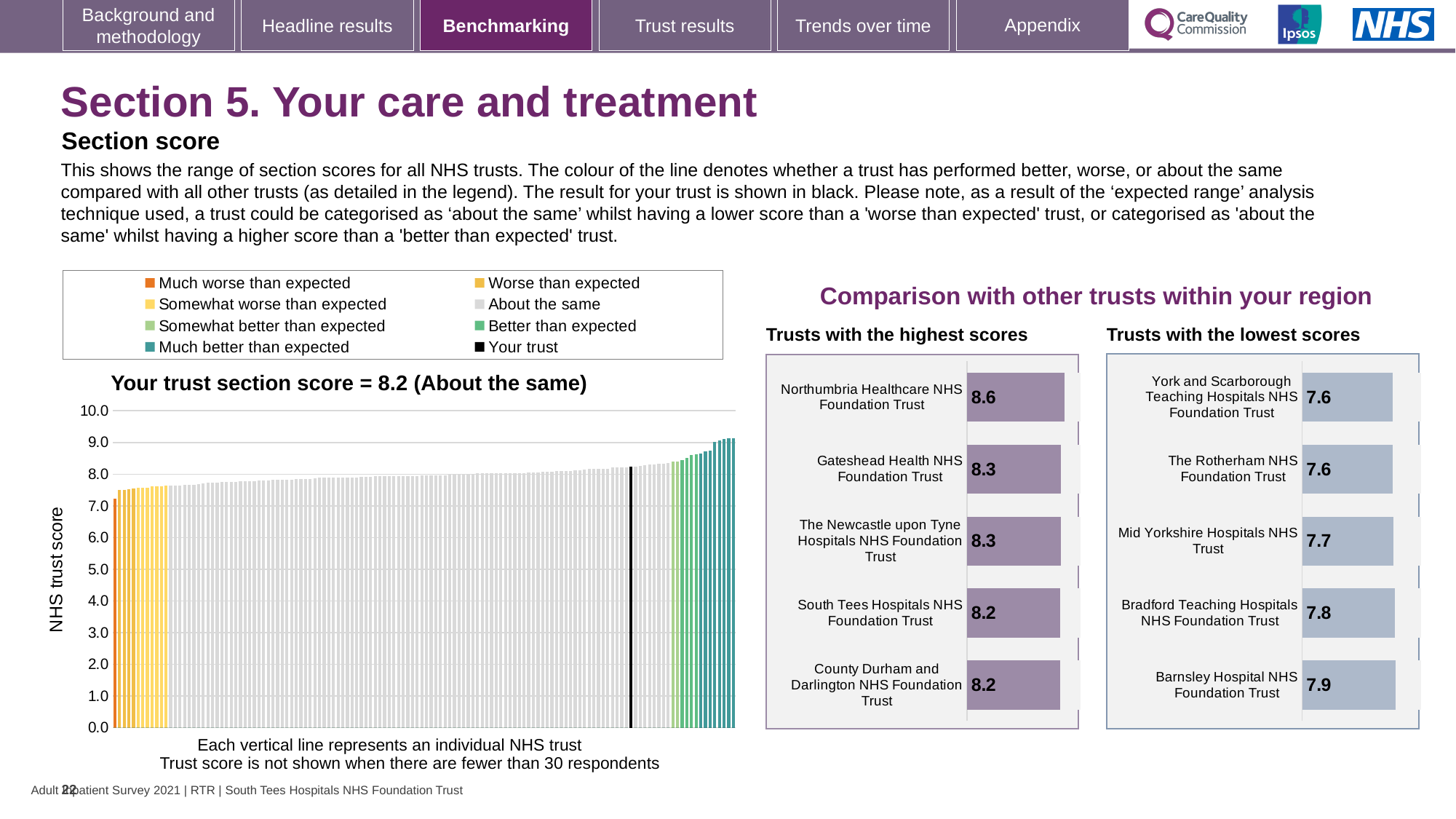
In the main chart 'Your trust section score', what is the section score for your trust? 8.2 In the 'Trusts with the highest scores' chart, what is the score for Northumbria Healthcare NHS Foundation Trust? 8.6 In the 'Trusts with the highest scores' chart, which trust has the highest score? Northumbria Healthcare NHS Foundation Trust In the 'Trusts with the lowest scores' chart, what is the score for Barnsley Hospital NHS Foundation Trust? 7.9 In the 'Trusts with the highest scores' chart, what is the difference between the scores of Northumbria Healthcare NHS Foundation Trust and South Tees Hospitals NHS Foundation Trust? 0.4 In the 'Trusts with the lowest scores' chart, what is the score for Mid Yorkshire Hospitals NHS Trust? 7.7 In the 'Trusts with the highest scores' chart, what is the score for Gateshead Health NHS Foundation Trust? 8.3 In the 'Trusts with the lowest scores' chart, which trust has the highest score shown? Barnsley Hospital NHS Foundation Trust How many entries does the legend above the main chart list? 8 In the main chart 'Your trust section score', do the bars rise or fall from left to right? rise In the 'Trusts with the lowest scores' chart, which has the larger score: Bradford Teaching Hospitals NHS Foundation Trust or Mid Yorkshire Hospitals NHS Trust? Bradford Teaching Hospitals NHS Foundation Trust How many trusts are listed in the 'Trusts with the lowest scores' chart? 5